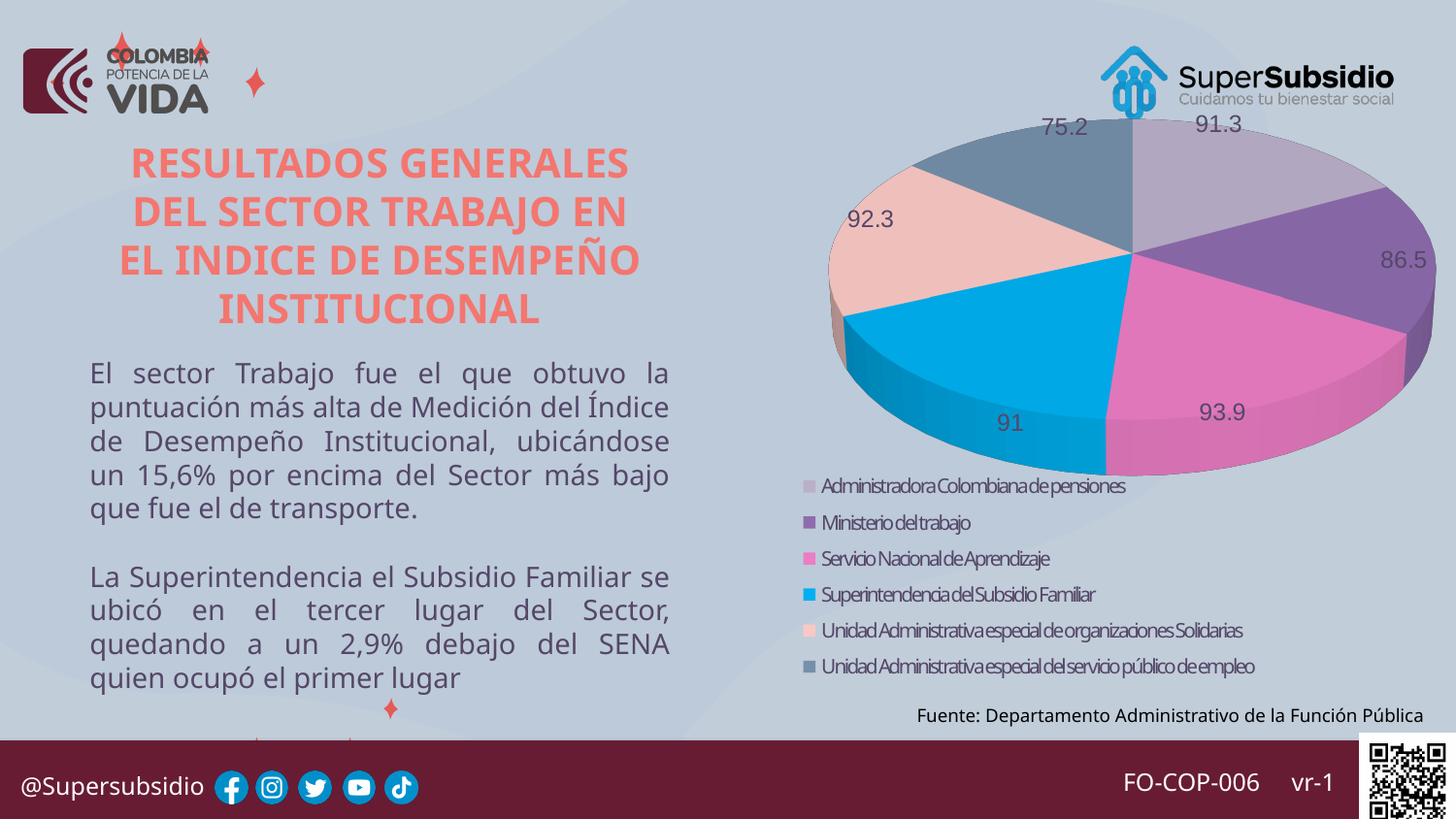
Which has a larger value, Administradora Colombiana de pensiones or Ministerio del trabajo? Administradora Colombiana de pensiones What is the difference between the values for Servicio Nacional de Aprendizaje and Superintendencia del Subsidio Familiar? 2.9 How many slices does the pie chart have? 6 What is the value for Unidad Administrativa especial del servicio público de empleo in the pie chart? 75.2 What is the value for Superintendencia del Subsidio Familiar in the pie chart? 91 What is the value for Ministerio del trabajo in the pie chart? 86.5 What colour is the slice for Superintendencia del Subsidio Familiar? Blue What type of chart is shown on the slide? Pie chart What is the value for Servicio Nacional de Aprendizaje in the pie chart? 93.9 Which entity has the highest value in the pie chart? Servicio Nacional de Aprendizaje What is the total of all the values shown in the pie chart? 530.2 Which entity has the lowest value in the pie chart? Unidad Administrativa especial del servicio público de empleo